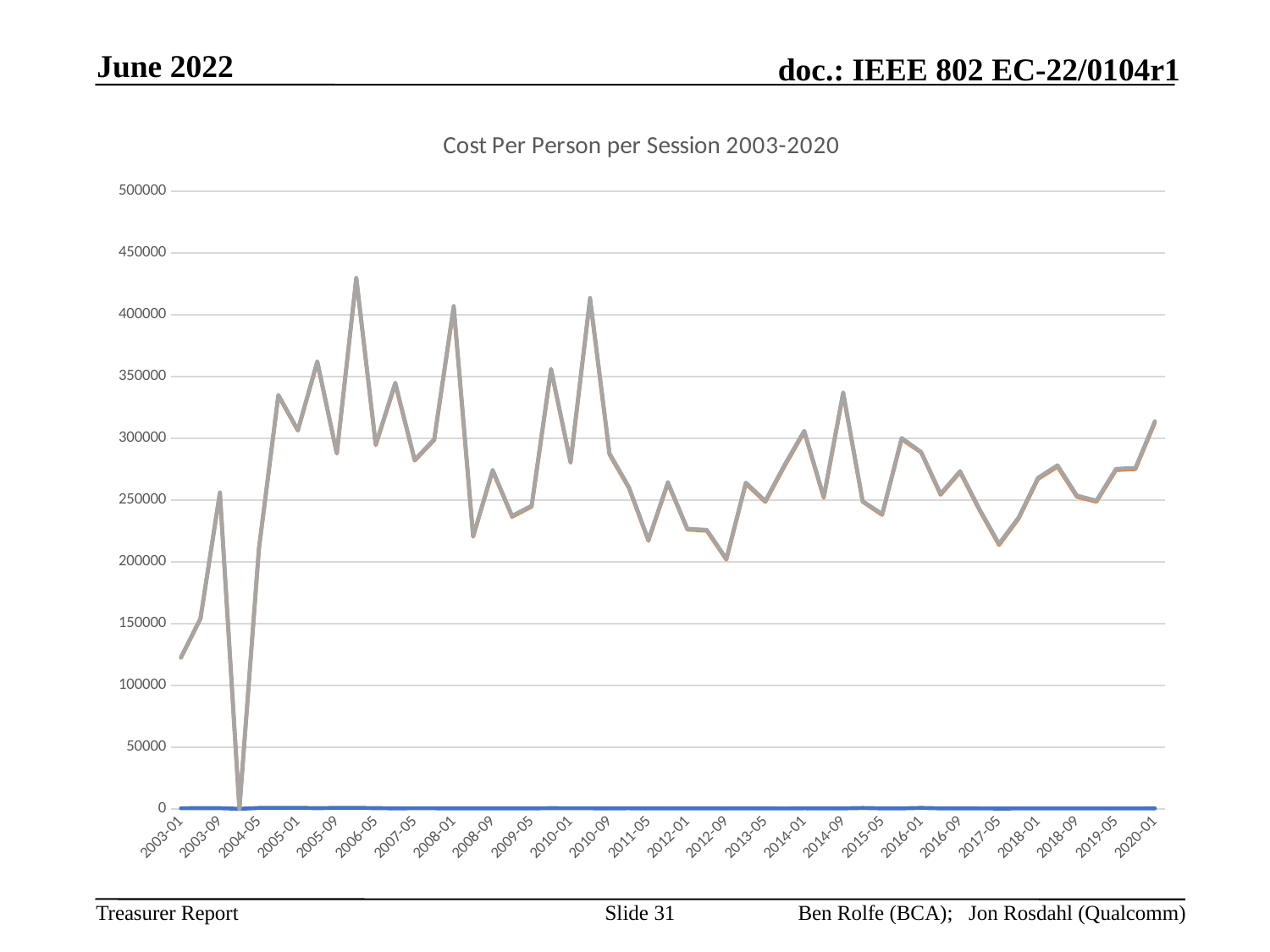
Is the value for 2003-01 greater or less than 150000? less Which is larger, the value for 2008-01 or the value for 2011-05? 2008-01 What is the title of the chart? Cost Per Person per Session 2003-2020 Is the value for 2017-05 greater or less than 250000? less What is the highest value shown on the vertical axis? 500000 Is the value for 2008-01 greater or less than 350000? greater What kind of chart is shown on the slide? line chart Which is larger, the value for 2003-01 or the value for 2004-05? 2004-05 Does the value rise or fall from 2010-09 to 2011-05? fall